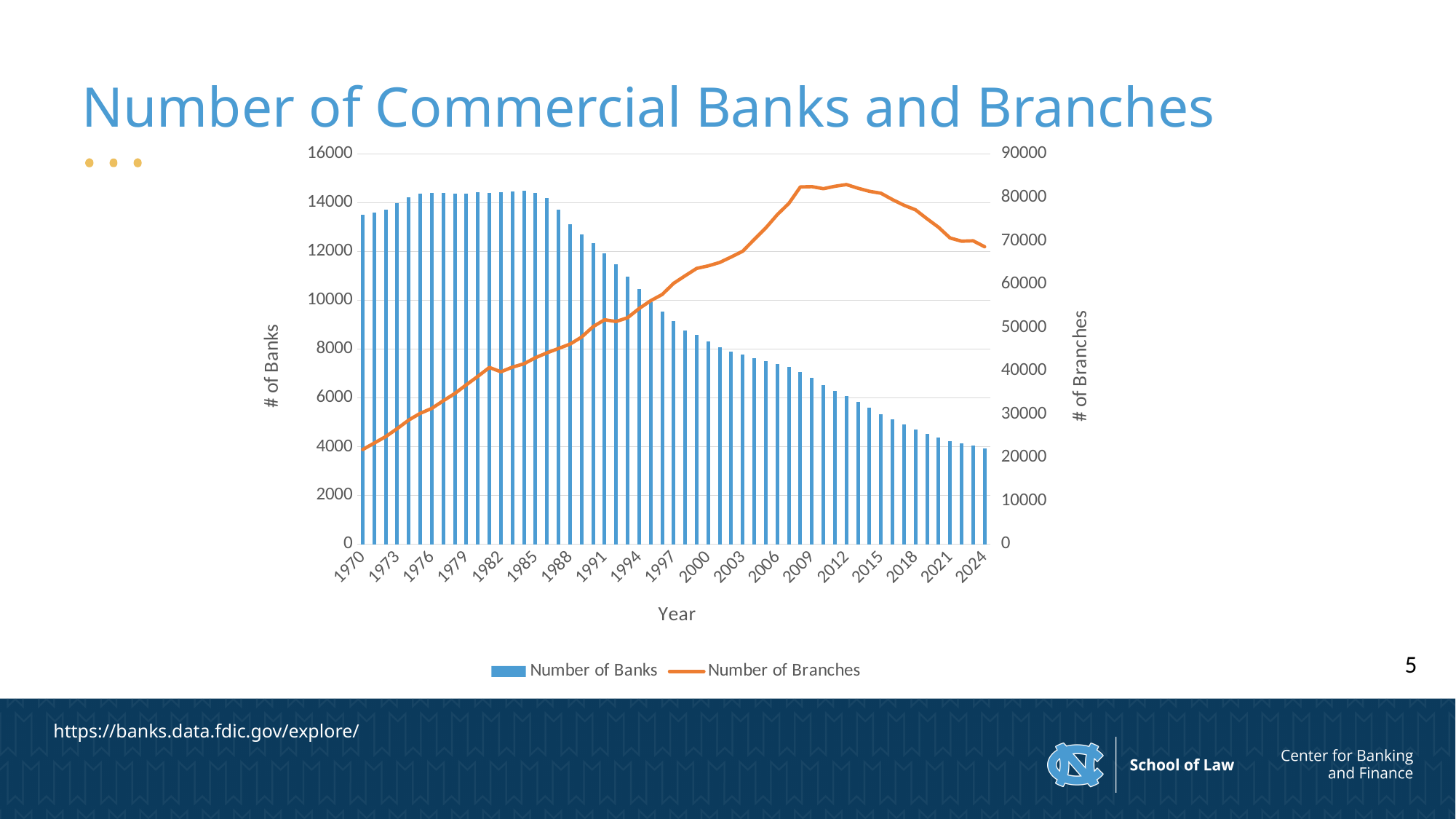
What kind of chart is shown on the slide? A bar chart combined with a line chart What is the label on the right-hand vertical axis? # of Branches Which is larger, the Number of Banks in 1985 or in 2024? 1985 Does the Number of Branches rise or fall from 1970 to 2009? rise Is the Number of Branches in 2012 greater or less than 70000? greater Which year has the lowest Number of Banks? 2024 What is the title of the chart? Number of Commercial Banks and Branches Is the Number of Branches in 1970 greater or less than 30000? less Is the Number of Banks in 2024 greater or less than 6000? less Does the Number of Banks rise or fall from 1985 to 2024? fall How many series does the legend list? 2